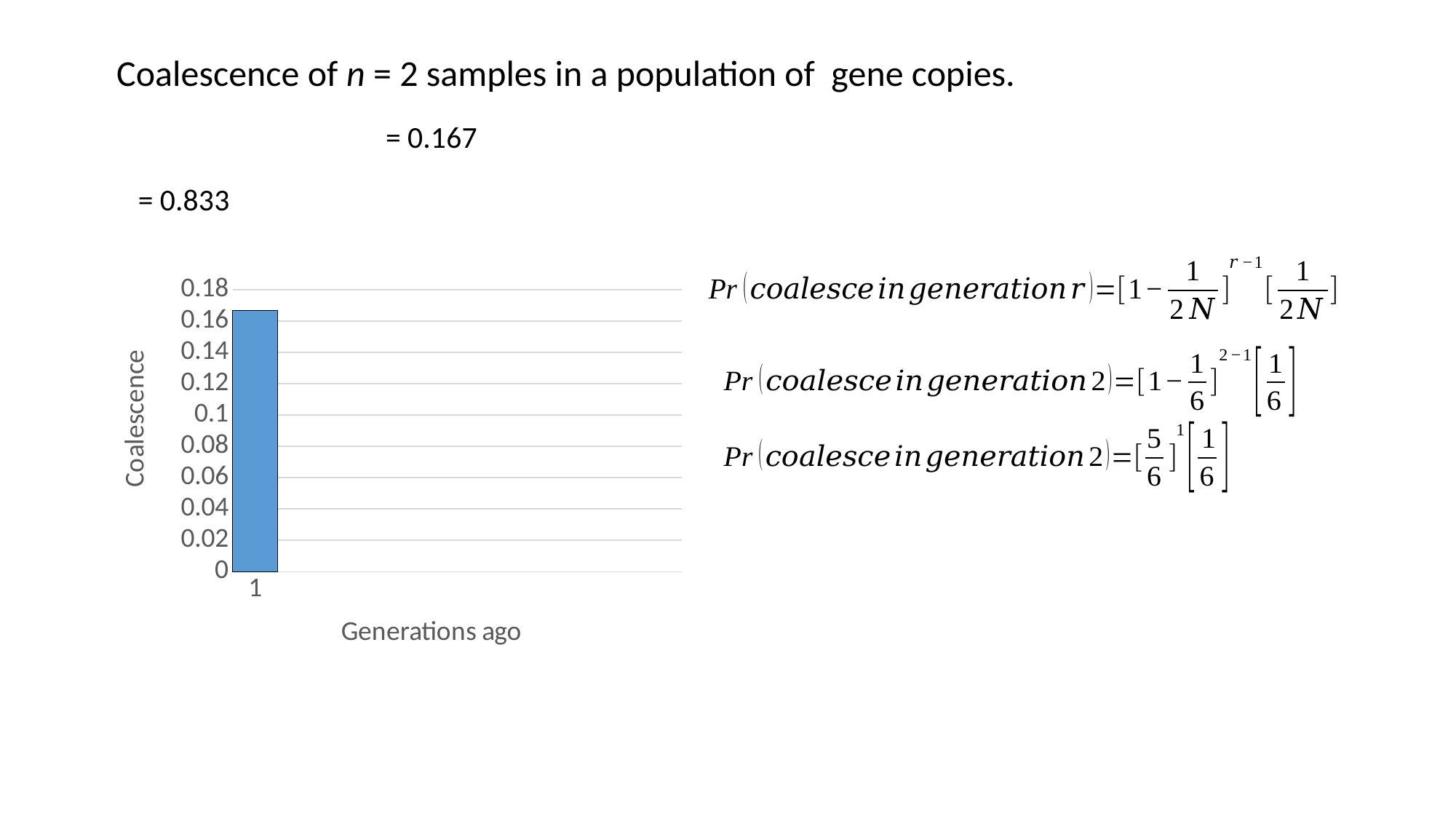
What is the label on the vertical axis of the chart? Coalescence Is the value of the bar for generation 1 greater or less than 0.1? greater What kind of chart is shown on the slide? bar chart What is the highest value shown on the vertical axis of the chart? 0.18 How many bars are plotted in the chart? 1 Is the value of the bar for generation 1 greater or less than 0.14? greater Is the value of the bar for generation 1 greater or less than 0.18? less What is the label on the horizontal axis of the chart? Generations ago What is the category label shown under the single bar? 1